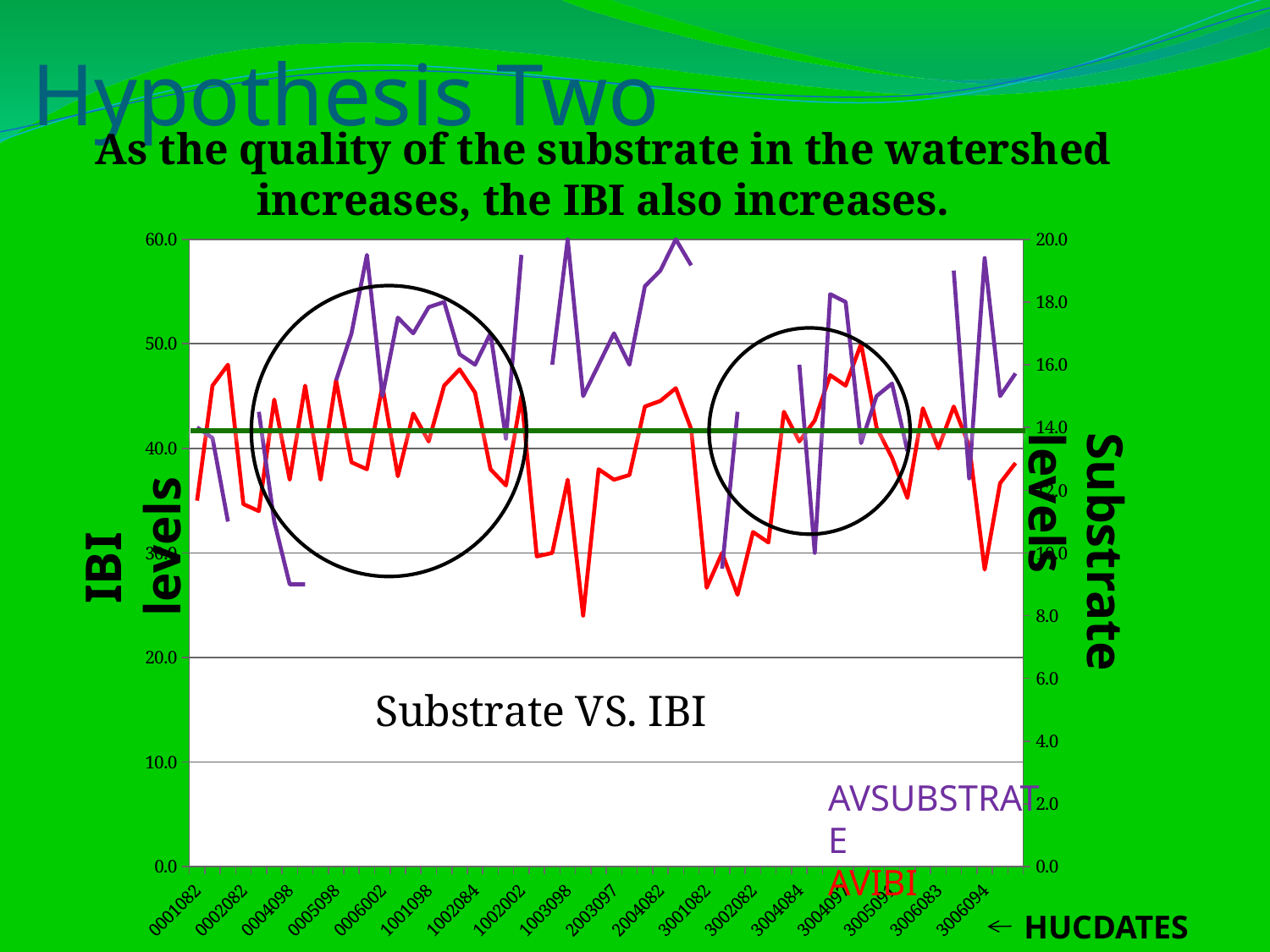
How many series does the chart's legend list? 2 Is the lowest value of the AVSUBSTRATE series greater or less than 10.0 on the Substrate levels axis? less Which series is drawn in red? AVIBI How many HUCDATES labels are shown along the x axis? 18 Is the lowest value of the AVIBI series greater or less than 30.0 on the IBI levels axis? less What kind of chart is shown on the slide? line chart What is the title of the chart? Substrate VS. IBI